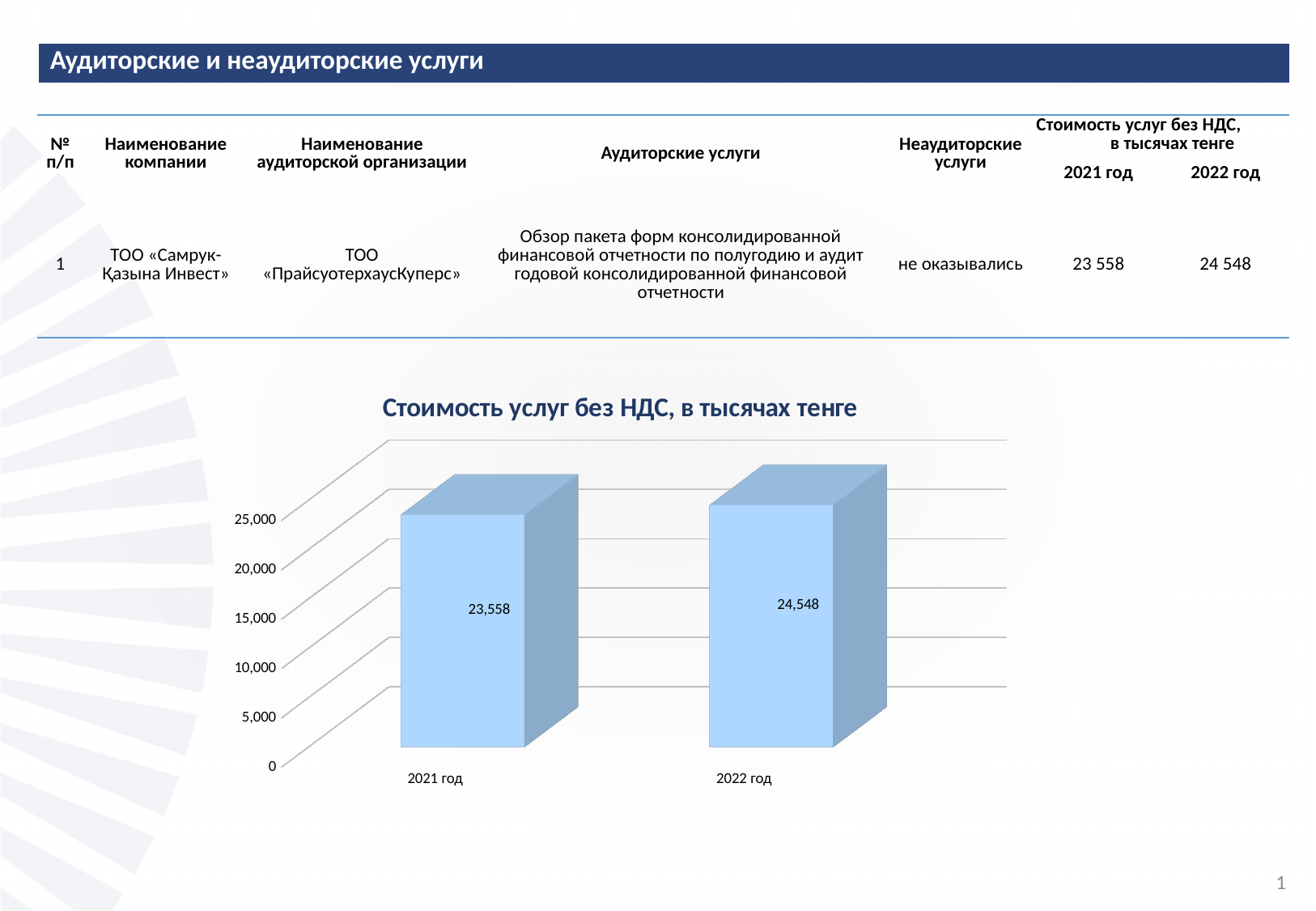
What is the value for 2021 год in the chart? 23,558 Which year has the higher value in the chart? 2022 год What is the title of the chart? Стоимость услуг без НДС, в тысячах тенге What is the value for 2022 год in the chart? 24,548 Is the value for 2022 год greater or less than 25,000? less How many bars are plotted in the chart? 2 Which year has the lower value in the chart? 2021 год Do the values rise or fall from 2021 год to 2022 год? rise What is the difference between the values for 2022 год and 2021 год in the chart? 990 What kind of chart is shown on the slide? bar chart Is the value for 2021 год larger or smaller than the value for 2022 год? smaller Is the value for 2021 год greater or less than 20,000? greater